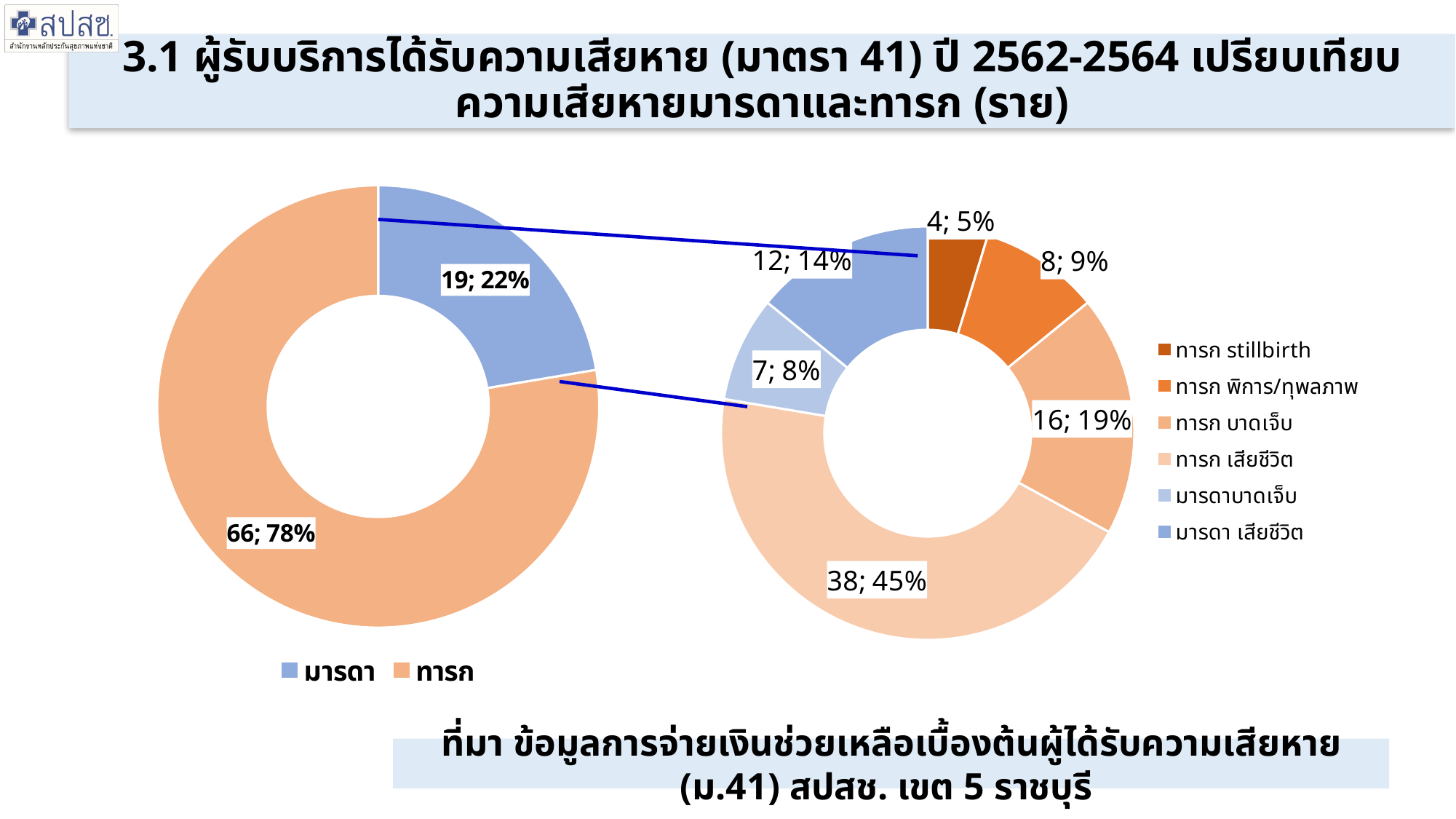
On the left doughnut chart, what share of the total does ทารก represent? 78% On the right doughnut chart, what value is shown for ทารก เสียชีวิต? 38; 45% On the left doughnut chart, what value is shown for มารดา? 19; 22% How many categories does the legend of the right doughnut chart list? 6 On the right doughnut chart, what is the difference between ทารก บาดเจ็บ and ทารก พิการ/ทุพลภาพ? 8 On the left doughnut chart, what is the difference between the ทารก count and the มารดา count? 47 On the right doughnut chart, which category has the largest value? ทารก เสียชีวิต On the left doughnut chart, what value is shown for ทารก? 66; 78% What type of chart is used on the left side of the slide? Doughnut (pie) chart On the right doughnut chart, which category has the smallest value? ทารก stillbirth On the right doughnut chart, what value is shown for มารดาบาดเจ็บ? 7; 8% On the right doughnut chart, which is larger: ทารก บาดเจ็บ or มารดา เสียชีวิต? ทารก บาดเจ็บ